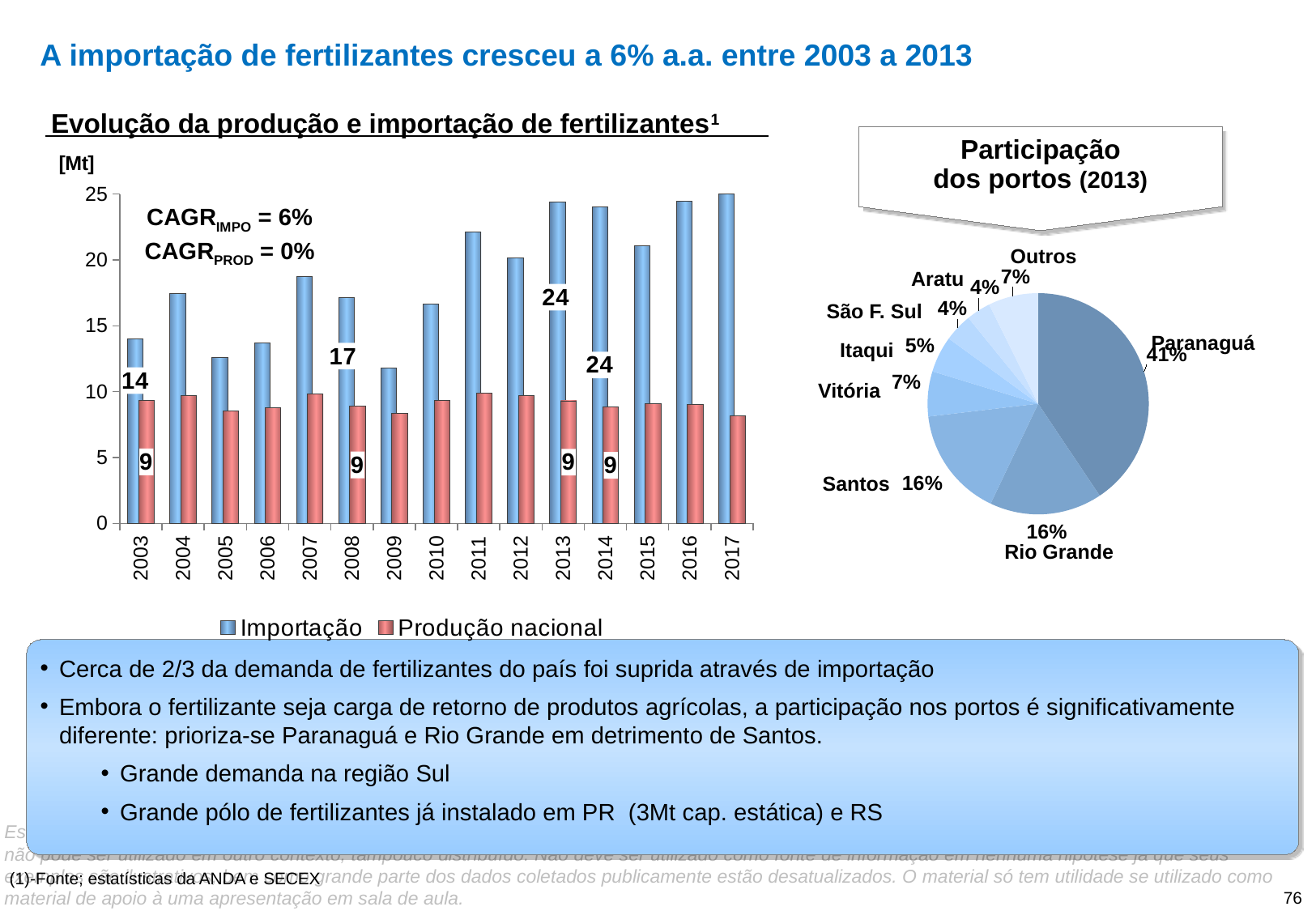
In the bar chart 'Evolução da produção e importação de fertilizantes', is the Importação value for 2017 greater or less than 20? greater How many slices does the pie chart 'Participação dos portos (2013)' have? 8 In the bar chart 'Evolução da produção e importação de fertilizantes', does Importação generally rise or fall from 2003 to 2017? rise What kind of chart is 'Participação dos portos (2013)'? pie chart In the pie chart 'Participação dos portos (2013)', which port has the largest share? Paranaguá In the bar chart 'Evolução da produção e importação de fertilizantes', is the Produção nacional value for 2009 greater or less than 10? less How many series does the legend of the bar chart 'Evolução da produção e importação de fertilizantes' list? 2 In the bar chart 'Evolução da produção e importação de fertilizantes', what is the difference between Importação and Produção nacional in 2013? 15 In the pie chart 'Participação dos portos (2013)', what is the share for Santos? 16% In the bar chart 'Evolução da produção e importação de fertilizantes', what is the Produção nacional value for 2013? 9 In the bar chart 'Evolução da produção e importação de fertilizantes', which is larger: Importação in 2008 or Importação in 2003? 2008 In the bar chart 'Evolução da produção e importação de fertilizantes', what is the Importação value for 2003? 14